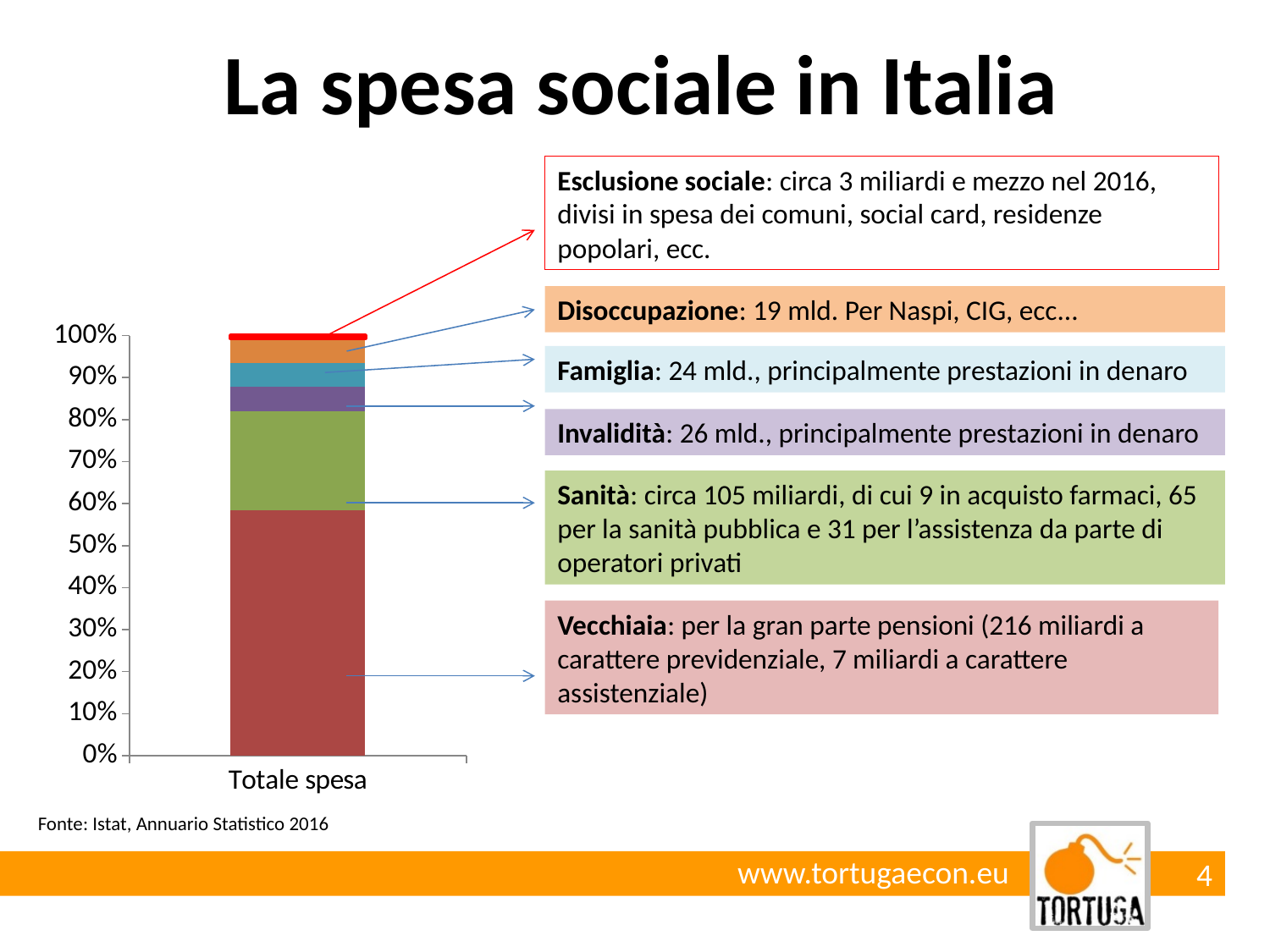
What kind of chart is shown on the slide? Stacked bar chart Which spending component occupies the smallest share of the stacked bar? Esclusione sociale How many segments make up the stacked bar for Totale spesa? 6 Which segment sits at the bottom of the stacked bar? Vecchiaia Which spending component occupies the largest share of the stacked bar? Vecchiaia How many categories are plotted on the x axis of the chart? 1 Which segment is larger in the stacked bar, Sanità or Invalidità? Sanità Is the share of the bar taken by Vecchiaia greater or less than 50%? greater What is the label of the single category on the x axis of the chart? Totale spesa Is the share of the bar taken by Sanità greater or less than 40%? less What is the highest value shown on the y axis of the chart? 100%